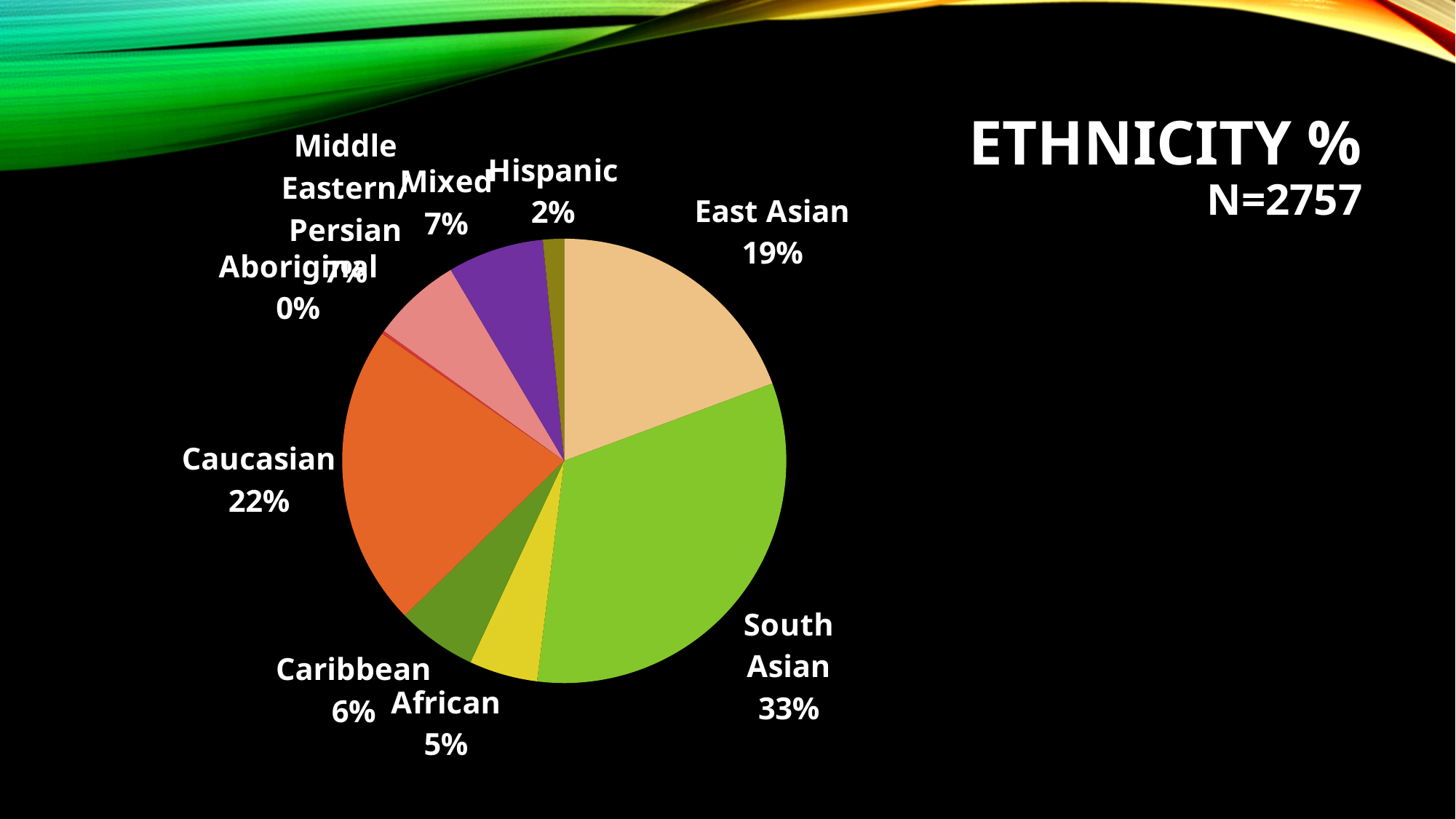
What percentage of the pie is South Asian? 33% Which ethnicity has the smallest share of the pie? Aboriginal How many percentage points larger is the South Asian share than the Caucasian share? 11 percentage points What sample size (N) is stated on the slide? N=2757 Which share is larger, East Asian or Caucasian? Caucasian How many ethnicity categories are shown in the pie chart? 9 What percentage is shown for Caucasian? 22% Which ethnicity has the largest share of the pie? South Asian What kind of chart is shown on the slide? Pie chart What percentage is shown for Hispanic? 2% What percentage is shown for East Asian? 19% How many percentage points larger is the Caribbean share than the African share? 1 percentage point